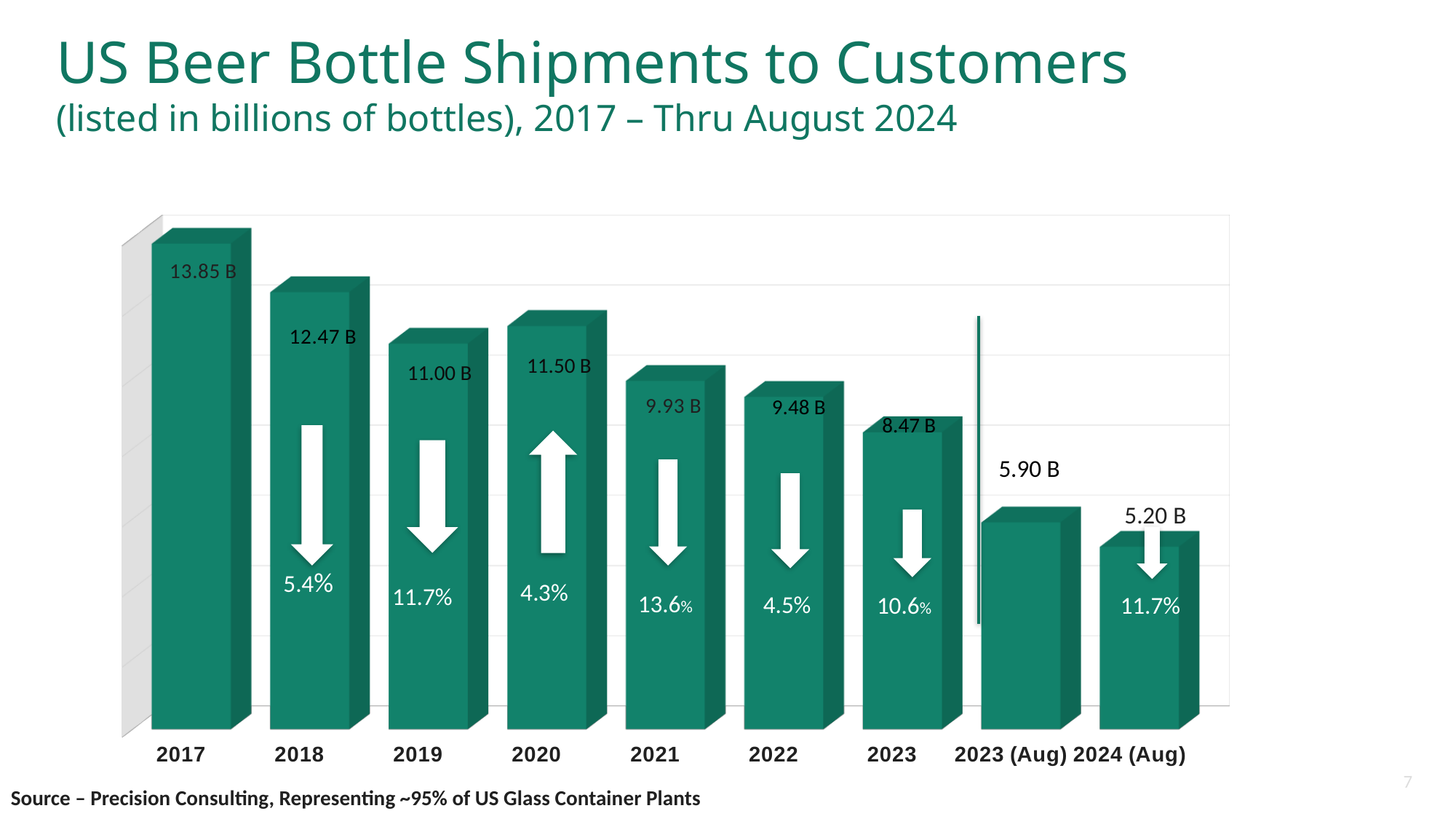
What is the value for 2024 (Aug)? 5.20 B What is the difference between the values for 2023 (Aug) and 2024 (Aug)? 0.70 B What kind of chart is this? Bar chart What is the value for 2023 (Aug)? 5.90 B What percentage change is labelled on the 2021 bar? 13.6% What is the difference between the values for 2017 and 2018? 1.38 B Which category has the highest value? 2017 What is the value for 2020? 11.50 B Which is larger, the value for 2019 or the value for 2020? 2020 Which category has the lowest value? 2024 (Aug) What is the value for 2017? 13.85 B How many categories are shown on the x axis? 9